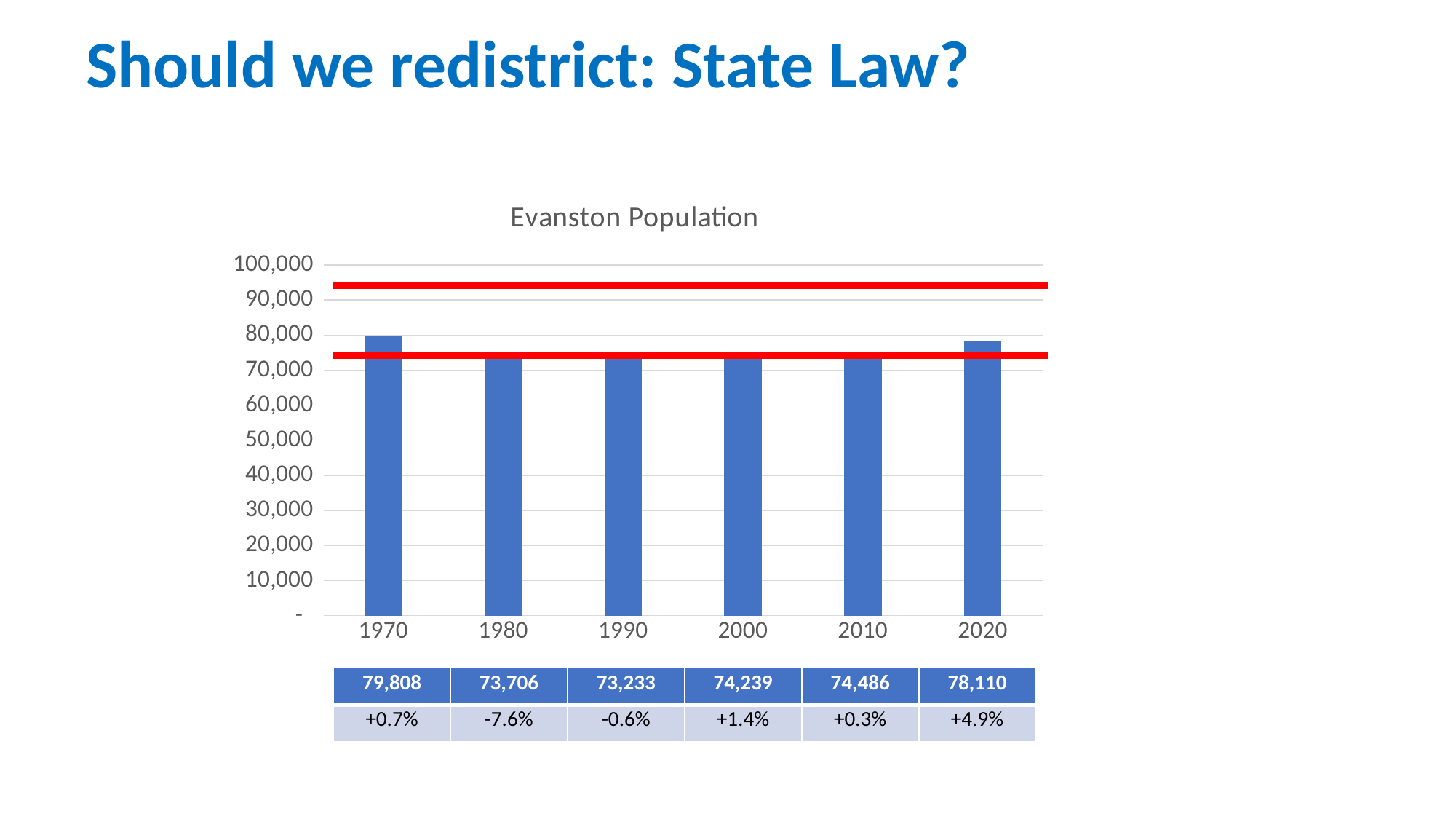
What is the Evanston population shown for 1970? 79,808 Is the value for 1980 greater or less than 80,000? less Which year has the lowest Evanston population? 1990 What percentage change is shown for 1980? -7.6% How many years are plotted in the chart? 6 Which is larger, the population in 2000 or in 2010? 2010 What is the Evanston population shown for 1990? 73,233 What is the difference between the 1970 and 2020 population values? 1,698 What is the Evanston population shown for 2020? 78,110 Which year has the highest Evanston population? 1970 What is the title of the chart? Evanston Population What kind of chart is shown on the slide? bar chart